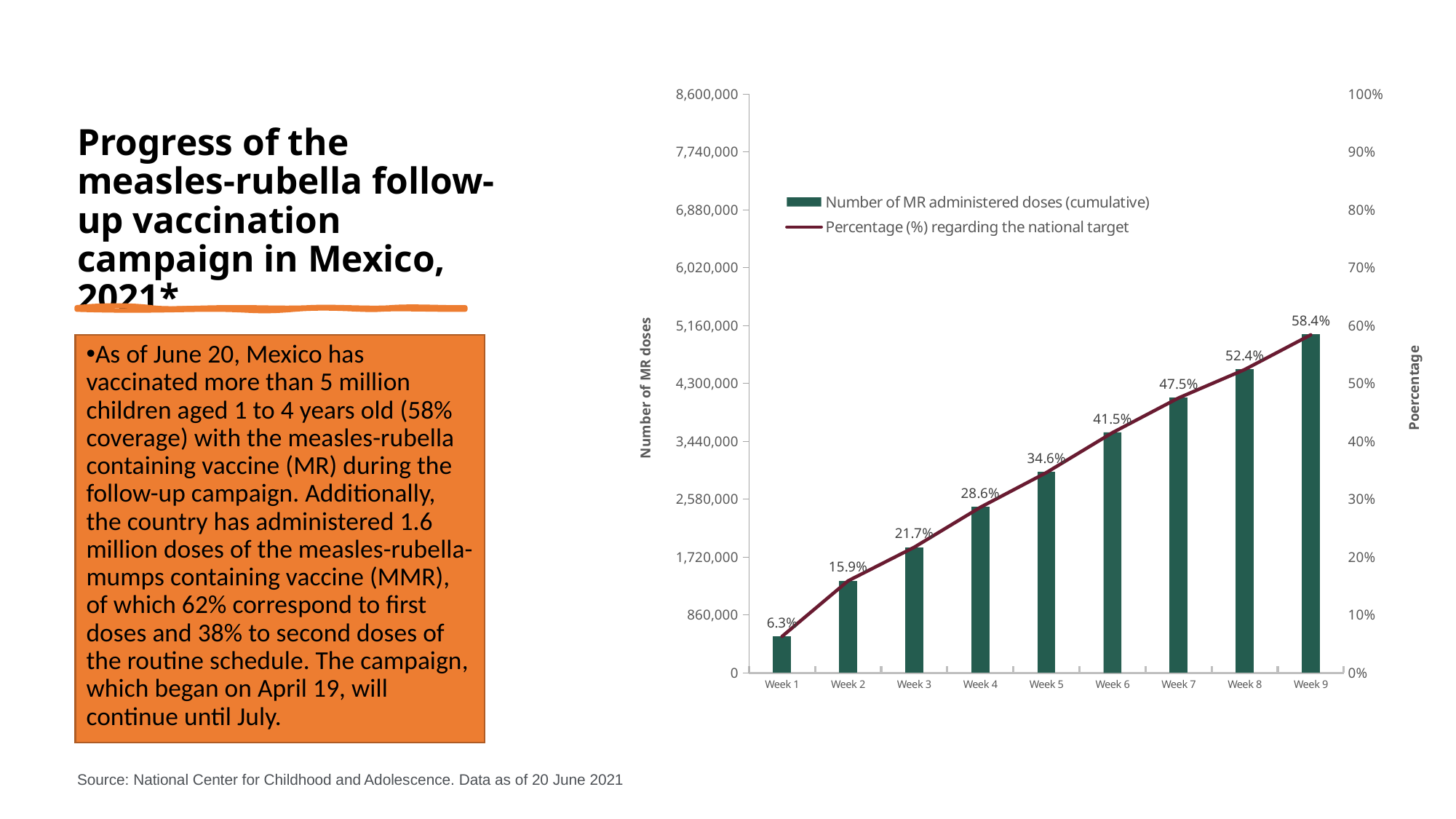
What is the difference in percentage regarding the national target between Week 9 and Week 8? 6.0% How many series does the chart legend list? 2 What is the percentage regarding the national target at Week 1? 6.3% What is the percentage regarding the national target at Week 5? 34.6% How many weeks are shown on the x axis of the chart? 9 What is the percentage regarding the national target at Week 9? 58.4% Which week has the highest percentage regarding the national target? Week 9 Which is larger, the percentage regarding the national target at Week 4 or at Week 6? Week 6 Is the number of MR administered doses (cumulative) at Week 1 greater or less than 860,000? less Which week has the lowest percentage regarding the national target? Week 1 Is the number of MR administered doses (cumulative) at Week 9 greater or less than 4,300,000? greater Does the percentage regarding the national target rise or fall from Week 1 to Week 9? rise